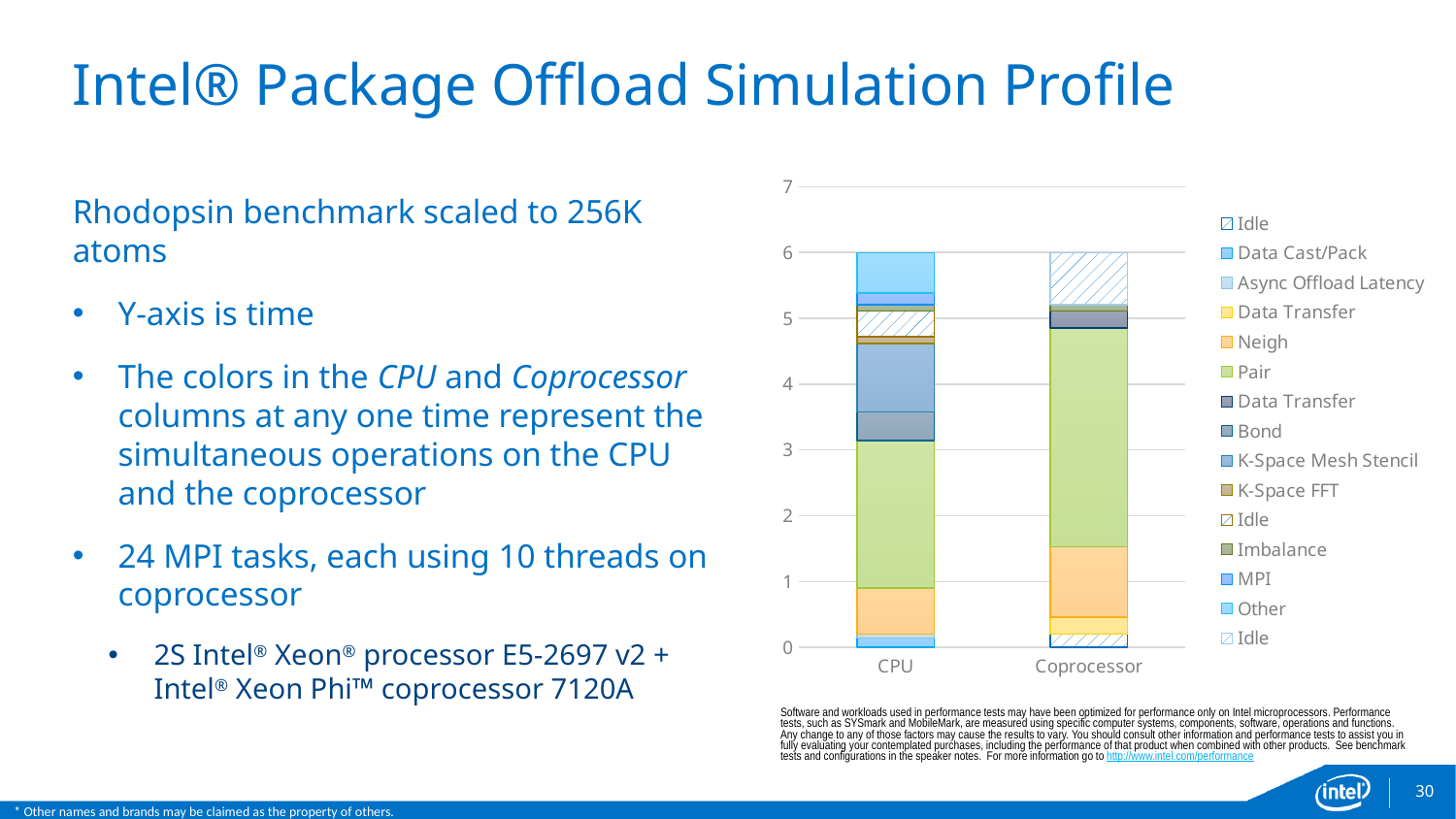
Is the total height of the CPU bar greater or less than 5? greater Is the total height of the Coprocessor bar greater or less than 7? less What is the total height of the stacked bar for CPU? 6 Is the top of the Pair segment in the Coprocessor bar greater or less than 4? greater What is the highest value shown on the y axis of the chart? 7 What is the total height of the stacked bar for Coprocessor? 6 How many entries does the chart's legend list? 15 What are the two categories on the x axis of the chart? CPU and Coprocessor How many categories are shown on the x axis of the chart? 2 What kind of chart is shown on the slide? Stacked bar chart